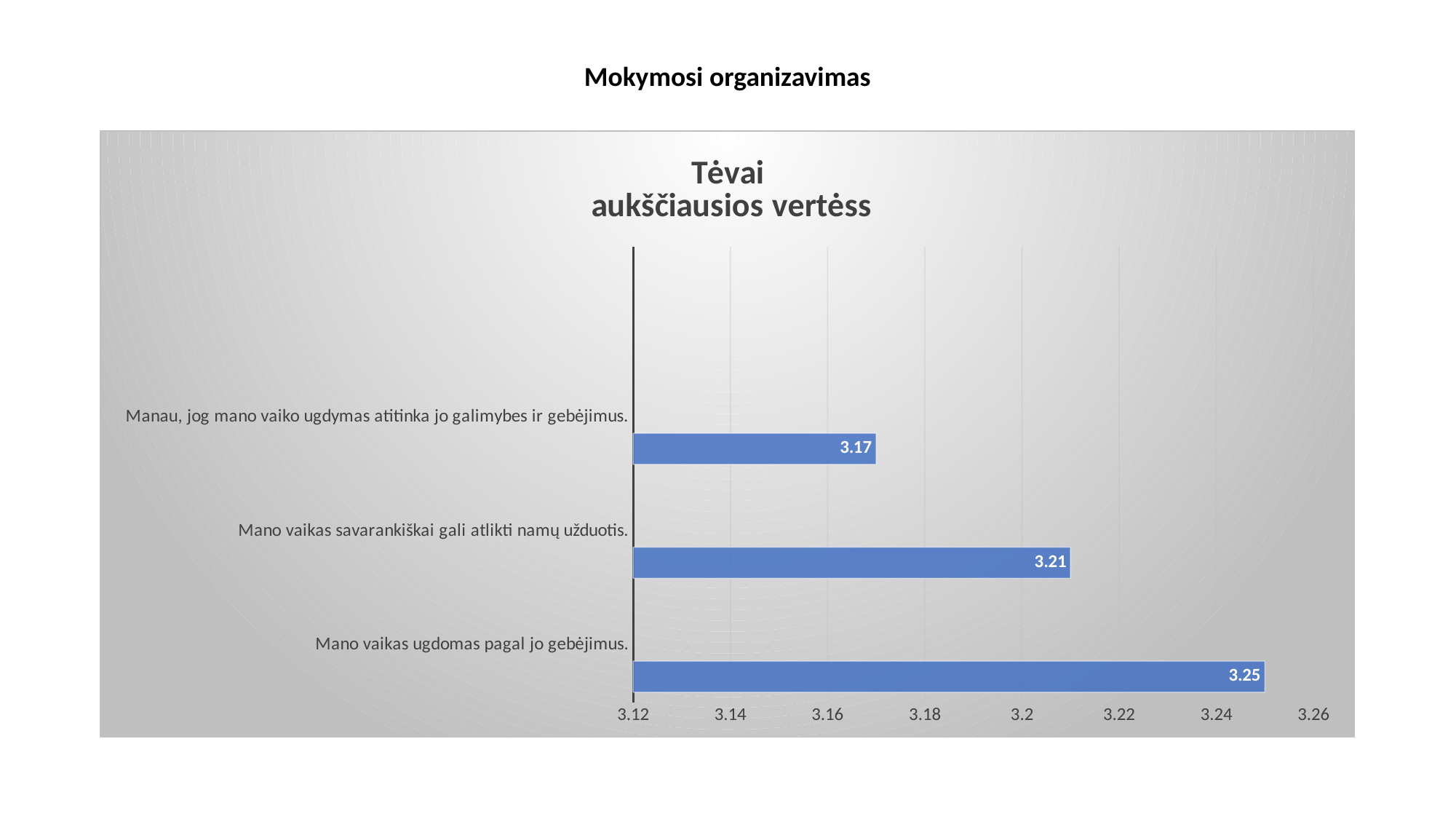
What is the title of the chart? Tėvai aukščiausios vertėss What is the value for "Mano vaikas ugdomas pagal jo gebėjimus."? 3.25 Which is larger: the value for "Mano vaikas savarankiškai gali atlikti namų užduotis." or for "Manau, jog mano vaiko ugdymas atitinka jo galimybes ir gebėjimus."? Mano vaikas savarankiškai gali atlikti namų užduotis. How many categories are shown in the chart? 3 Which category has the highest value? Mano vaikas ugdomas pagal jo gebėjimus. What is the difference between the values for "Mano vaikas ugdomas pagal jo gebėjimus." and "Manau, jog mano vaiko ugdymas atitinka jo galimybes ir gebėjimus."? 0.08 What is the value for "Mano vaikas savarankiškai gali atlikti namų užduotis."? 3.21 What kind of chart is shown on the slide? bar chart Is the value for "Mano vaikas ugdomas pagal jo gebėjimus." greater or less than 3.2? greater What is the value for "Manau, jog mano vaiko ugdymas atitinka jo galimybes ir gebėjimus."? 3.17 What is the difference between the values for "Mano vaikas savarankiškai gali atlikti namų užduotis." and "Manau, jog mano vaiko ugdymas atitinka jo galimybes ir gebėjimus."? 0.04 Which category has the lowest value? Manau, jog mano vaiko ugdymas atitinka jo galimybes ir gebėjimus.